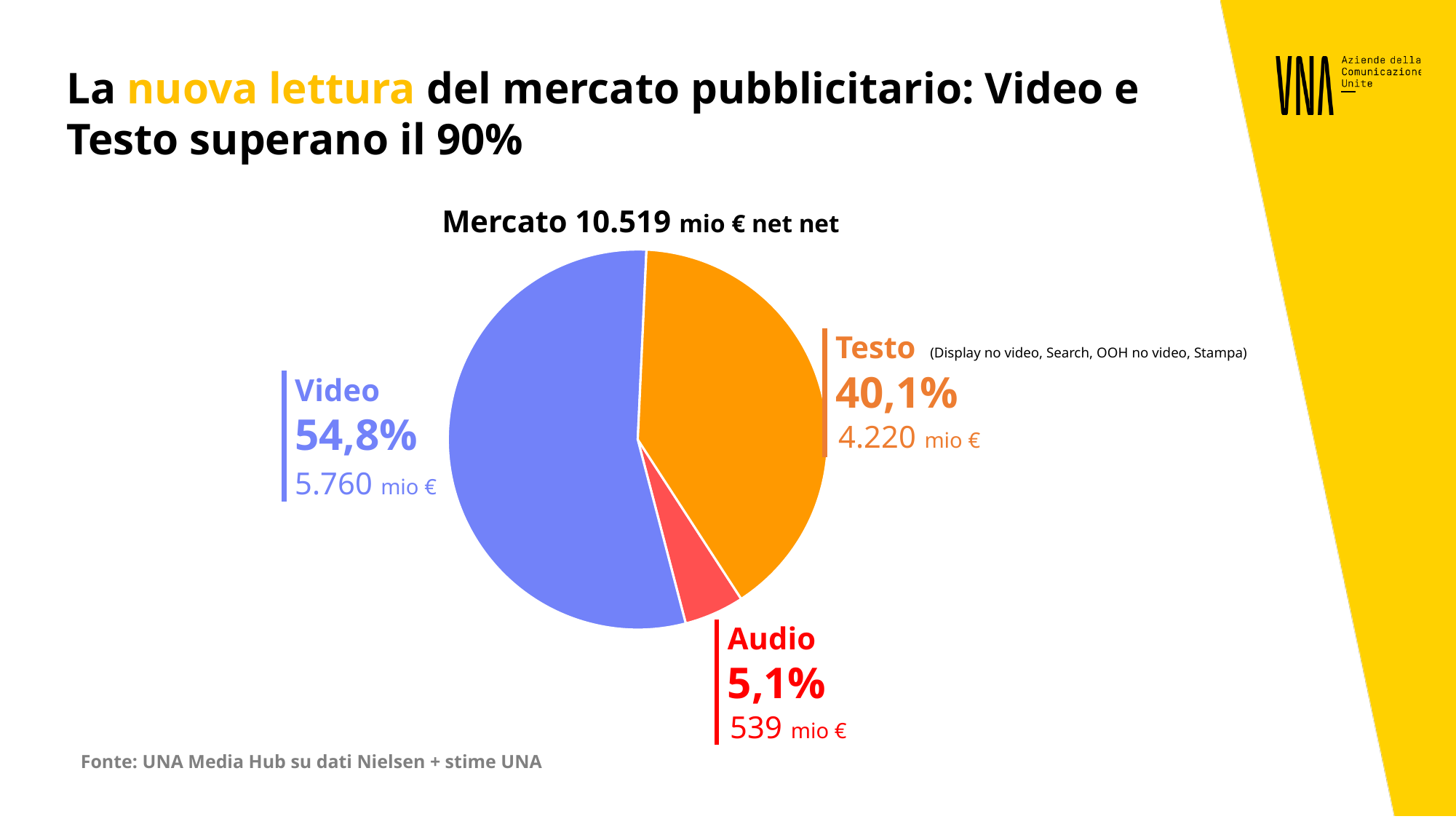
What is the value in mio € shown for Testo? 4.220 mio € Which category has the largest slice of the pie? Video What is the value in mio € shown for Video? 5.760 mio € What share of the pie does Audio represent? 5,1% What share of the pie does Video represent? 54,8% What total market value is stated in the chart title? 10.519 mio € net net What kind of chart is shown on the slide? pie chart What is the difference in percentage points between the Video and Testo shares? 14,7 How many slices does the pie chart have? 3 What share of the pie does Testo represent? 40,1% What is the value in mio € shown for Audio? 539 mio € Which category has the smallest slice of the pie? Audio